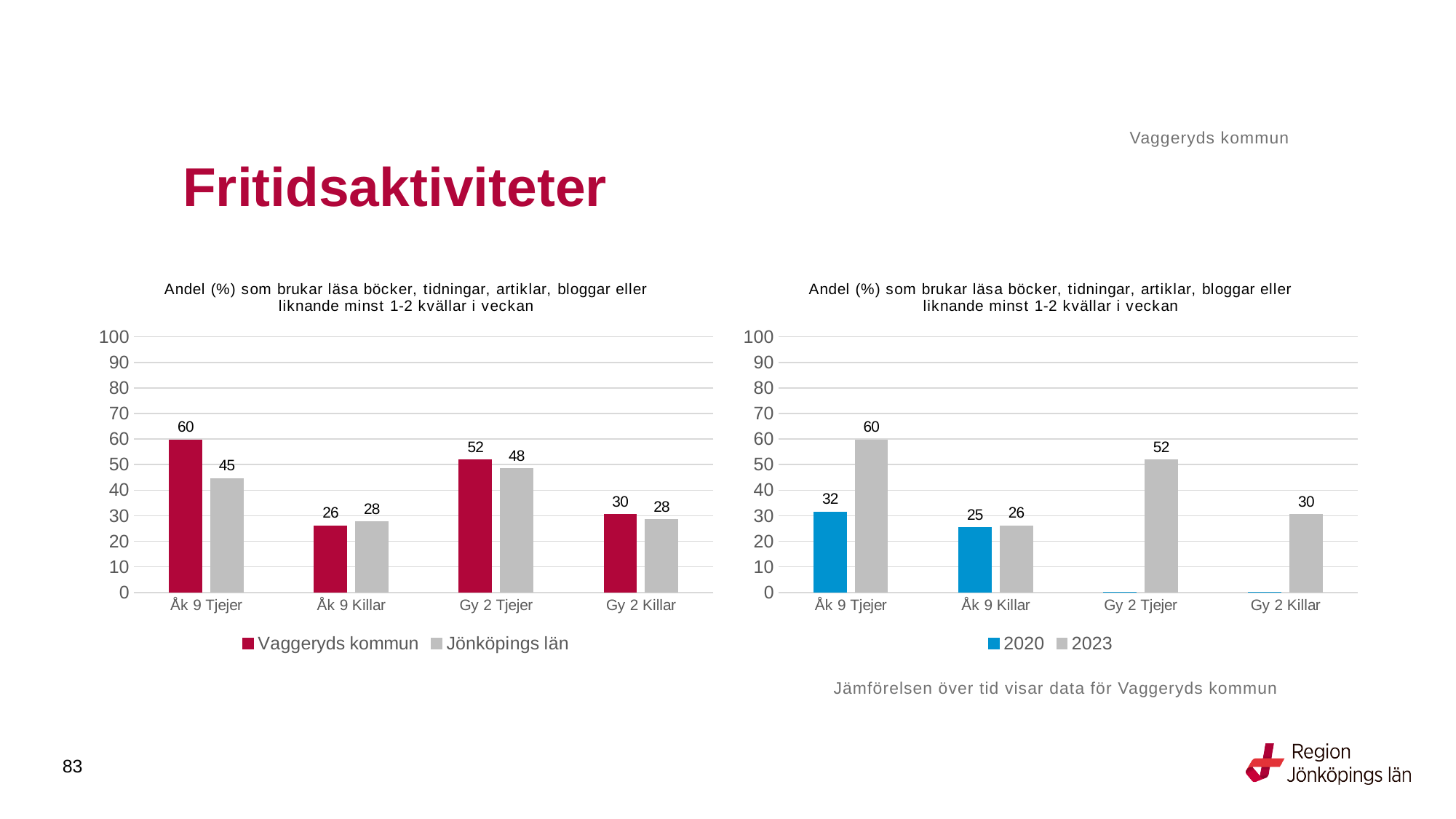
In the left chart, how many series does the legend list? 2 In the left chart, what is the value for Jönköpings län for Gy 2 Tjejer? 48 In the right chart, what is the value for 2020 for Åk 9 Tjejer? 32 In the right chart, how many categories are shown on the x axis? 4 In the right chart, what is the value for 2023 for Gy 2 Killar? 30 In the left chart, which is larger for Åk 9 Killar: Vaggeryds kommun or Jönköpings län? Jönköpings län In the right chart, what is the difference between 2023 and 2020 for Åk 9 Tjejer? 28 In the right chart, which category has the highest value for 2023? Åk 9 Tjejer In the left chart, what is the difference between Vaggeryds kommun and Jönköpings län for Åk 9 Tjejer? 15 In the left chart, what is the value for Vaggeryds kommun for Åk 9 Tjejer? 60 What type of chart is the right chart? Bar chart In the left chart, which category has the lowest value for Vaggeryds kommun? Åk 9 Killar